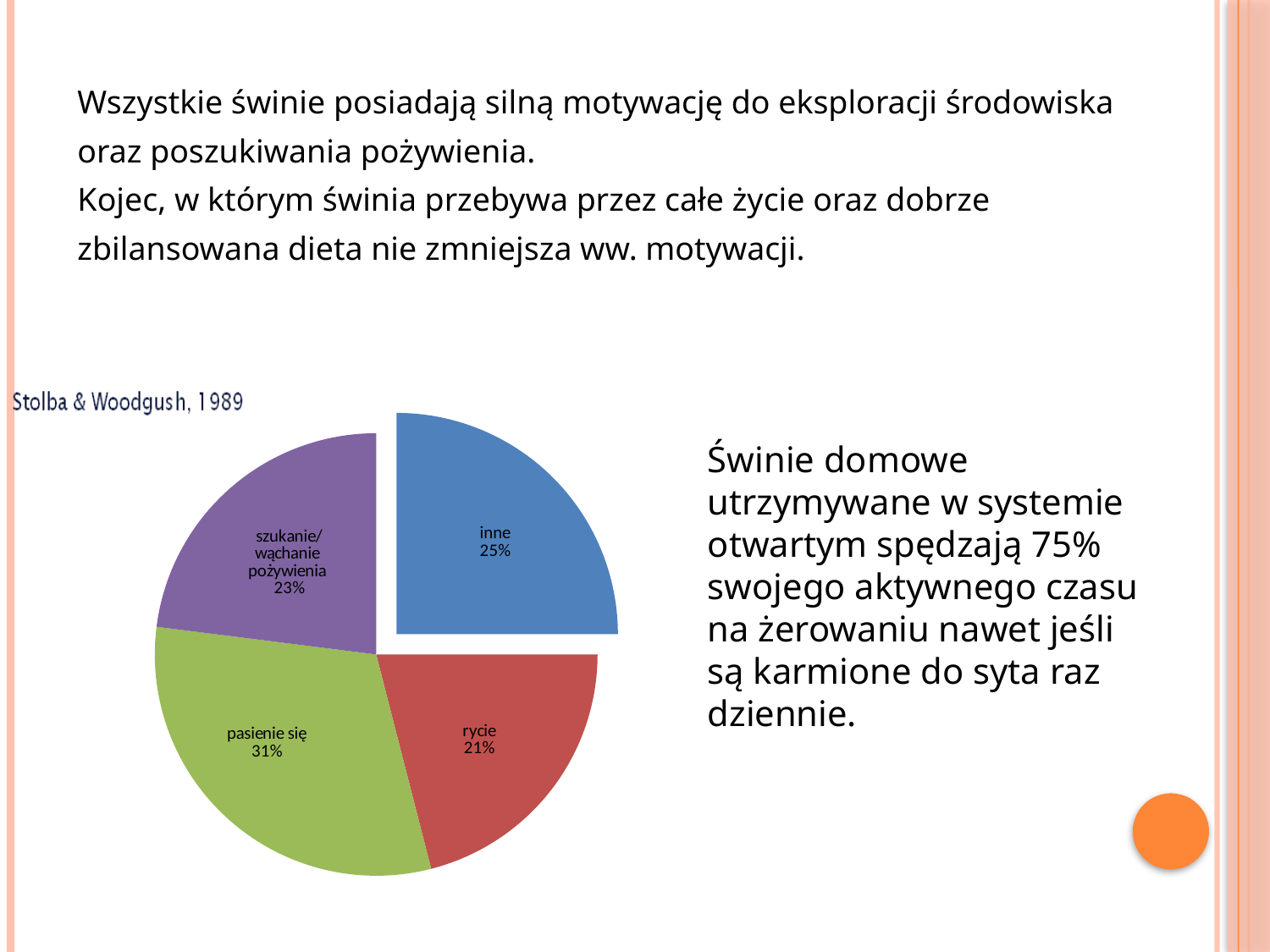
What share of the pie does "inne" represent? 25% What colour is the "inne" slice of the pie chart? blue What share of the pie does "pasienie się" represent? 31% Which is larger, the share for "inne" or the share for "szukanie/wąchanie pożywienia"? inne What is the difference in percentage points between "pasienie się" and "rycie"? 10 Which slice of the pie chart is the smallest? rycie What is the combined share of "pasienie się", "rycie" and "szukanie/wąchanie pożywienia"? 75% How many slices does the pie chart have? 4 Which slice of the pie chart is the largest? pasienie się What share of the pie does "rycie" represent? 21% What kind of chart is shown on the slide? pie chart